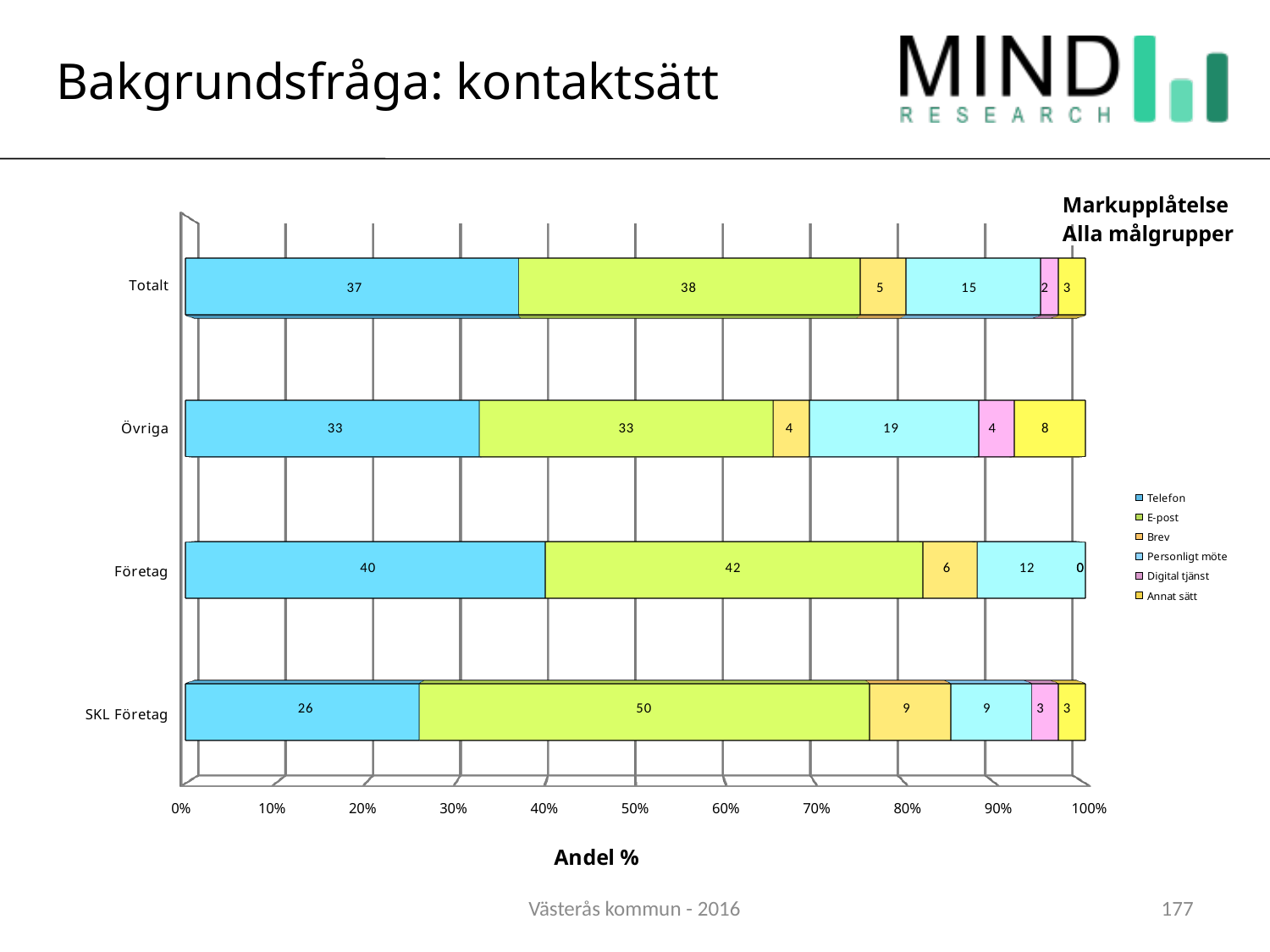
What is the E-post value for SKL Företag? 50 What is the Personligt möte value for Övriga? 19 What is the difference between the E-post values for SKL Företag and Totalt? 12 How many categories are shown on the y axis? 4 Which category has the lowest Telefon value? SKL Företag What kind of chart is shown on the slide? Stacked bar chart How many series does the legend list? 6 Which is larger, the Telefon value for Företag or the Telefon value for Övriga? Företag Which category has the highest E-post value? SKL Företag What is the Telefon value for Totalt? 37 What is the Annat sätt value for Övriga? 8 What is the Brev value for Företag? 6